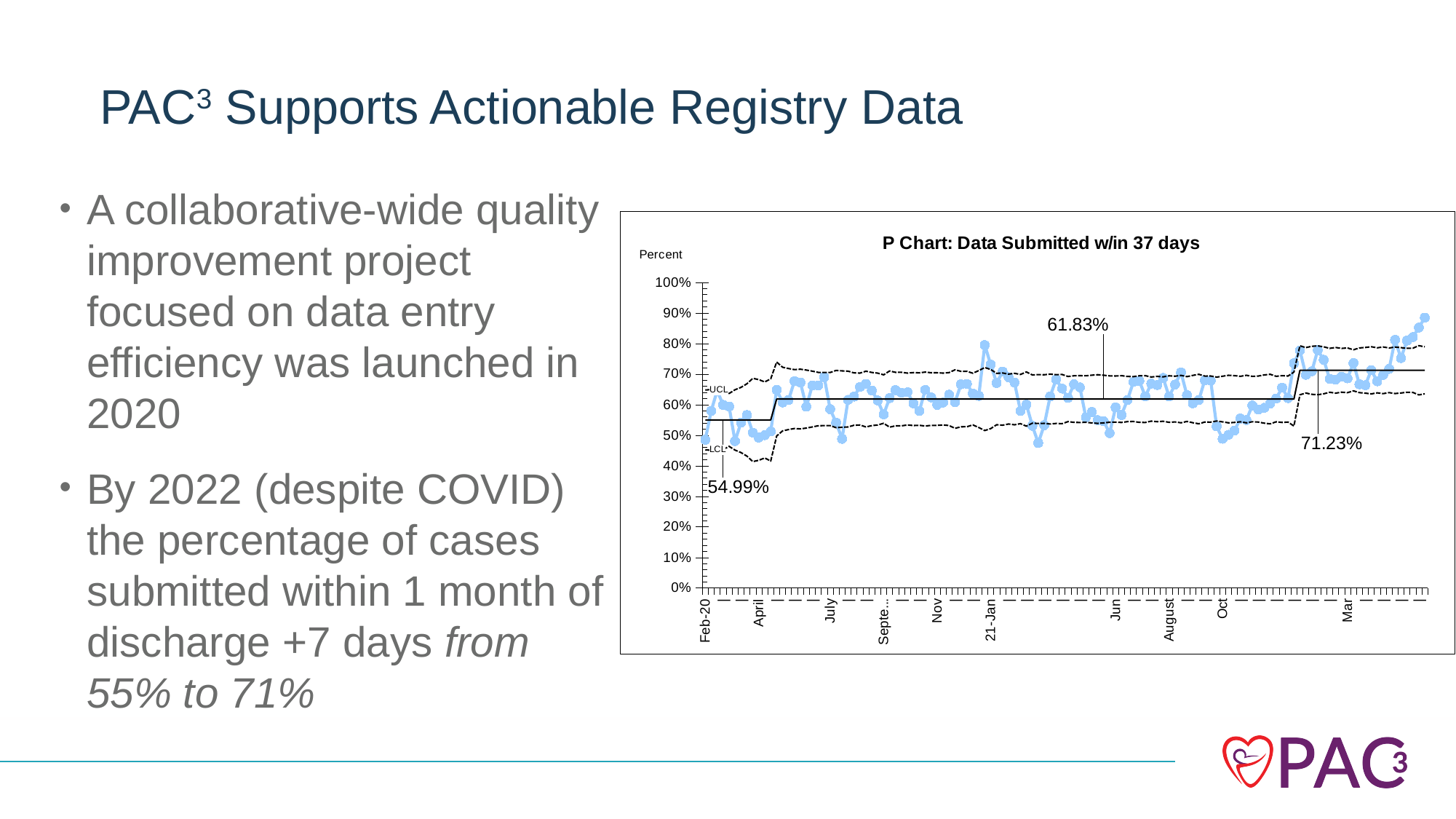
What is the label on the vertical axis of the chart? Percent What is the difference between the final center line value (71.23%) and the first center line value (54.99%)? 16.24 percentage points Do the center line values rise or fall from left to right across the chart? Rise What is the value of the first center line segment, labeled near the start of the chart? 54.99% What type of chart is shown on the slide? Line chart Which of the three labeled center line values is the highest? 71.23% What is the value of the middle center line segment in the chart? 61.83% What is the title of the chart? P Chart: Data Submitted w/in 37 days What is the difference between the center line values 71.23% and 61.83%? 9.40 percentage points Which of the three labeled center line values is the lowest? 54.99% Is the value of the last plotted point on the right of the chart greater or less than 80%? greater What is the value of the final center line segment in the chart? 71.23%